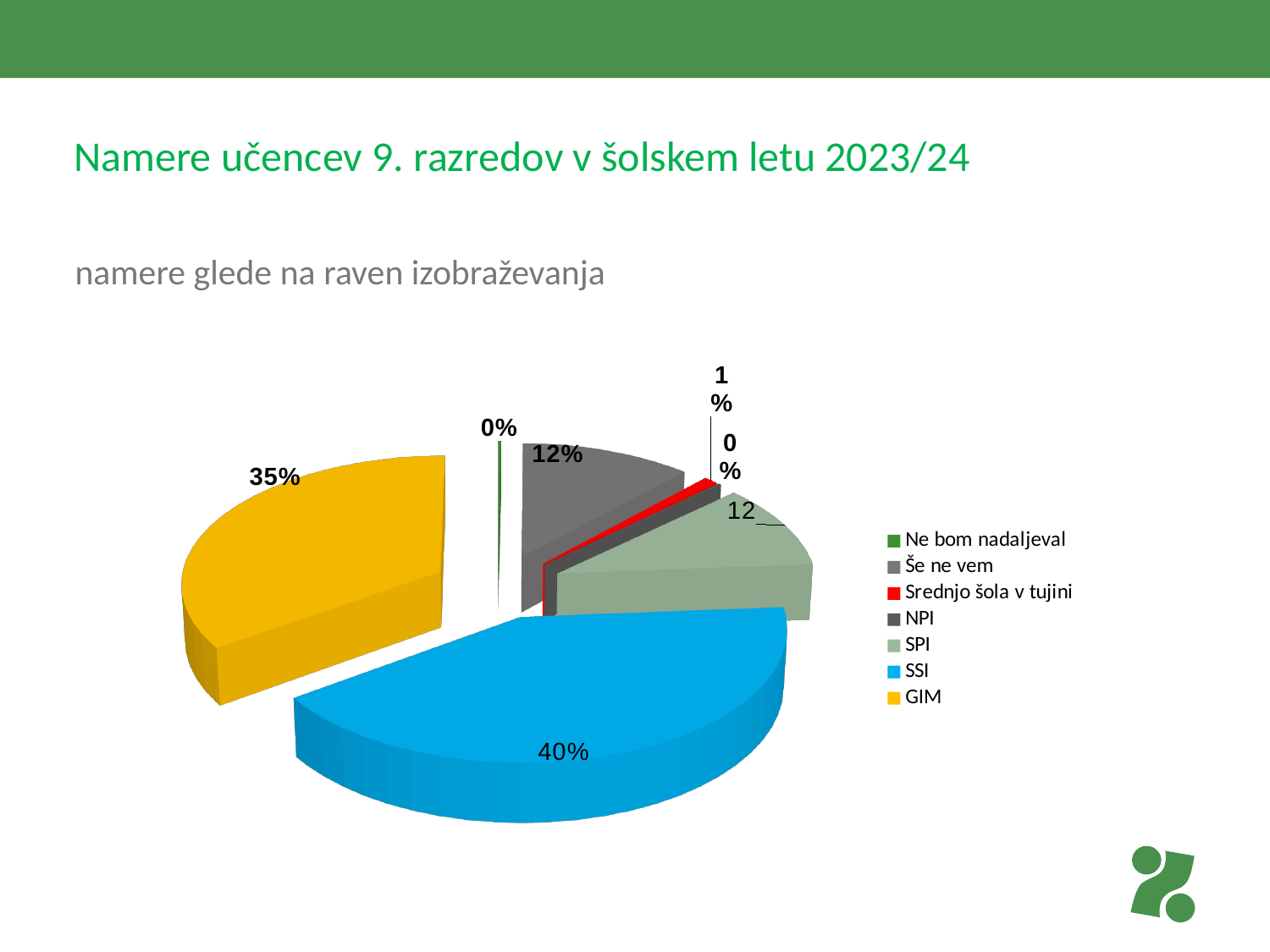
What is the title of the slide containing the pie chart? Namere učencev 9. razredov v šolskem letu 2023/24 What colour represents SSI in the pie chart? blue Which has a larger share of the pie chart, SSI or GIM? SSI What share of the pie chart does 'Srednjo šola v tujini' have? 1% What share of the pie chart does SSI have? 40% What share of the pie chart does GIM have? 35% What share of the pie chart does 'Ne bom nadaljeval' have? 0% By how many percentage points does the SSI share exceed the GIM share? 5 How many categories does the legend of the pie chart list? 7 What share of the pie chart does 'Še ne vem' have? 12% Which category has the largest share of the pie chart? SSI What kind of chart is shown on the slide? pie chart